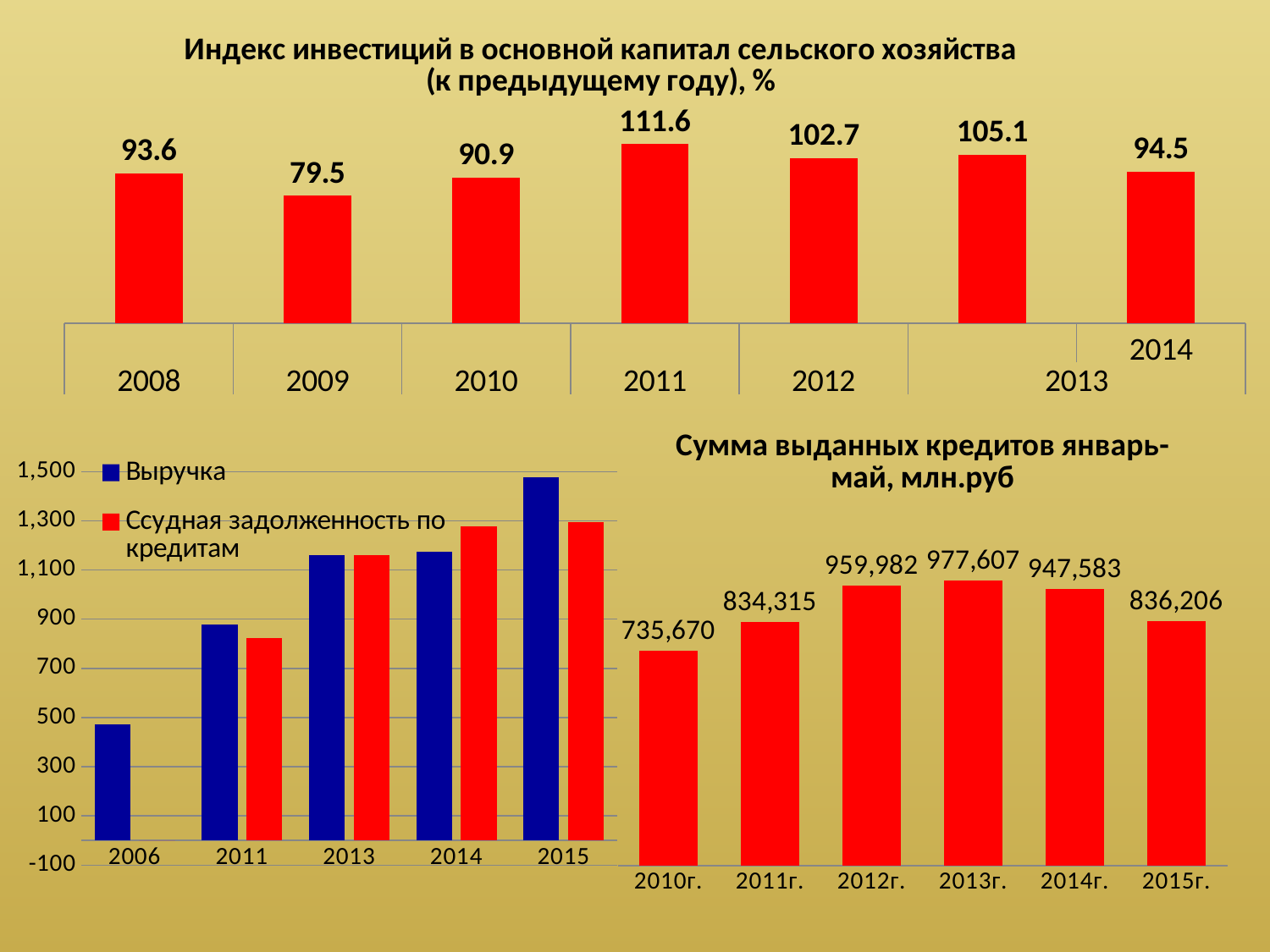
In the top chart 'Индекс инвестиций в основной капитал сельского хозяйства', which year has the lowest value? 2009 In the bottom-right chart 'Сумма выданных кредитов январь-май, млн.руб', what is the difference between the values for 2012г. and 2011г.? 125,667 In the top chart 'Индекс инвестиций в основной капитал сельского хозяйства', how many years are shown? 7 In the bottom-right chart 'Сумма выданных кредитов январь-май, млн.руб', what is the value for 2013г.? 977,607 In the bottom-left chart, how many series does the legend list? 2 In the bottom-left chart, is the value of Выручка for 2006 greater or less than 500? less In the top chart 'Индекс инвестиций в основной капитал сельского хозяйства', what is the value for 2011? 111.6 In the bottom-right chart 'Сумма выданных кредитов январь-май, млн.руб', which year has the lowest value? 2010г. In the bottom-right chart 'Сумма выданных кредитов январь-май, млн.руб', which is larger, the value for 2014г. or 2015г.? 2014г. In the bottom-left chart, is the value of Выручка for 2015 greater or less than 1,300? greater In the top chart 'Индекс инвестиций в основной капитал сельского хозяйства', which year has the highest value? 2011 In the top chart 'Индекс инвестиций в основной капитал сельского хозяйства', what is the difference between the values for 2013 and 2012? 2.4